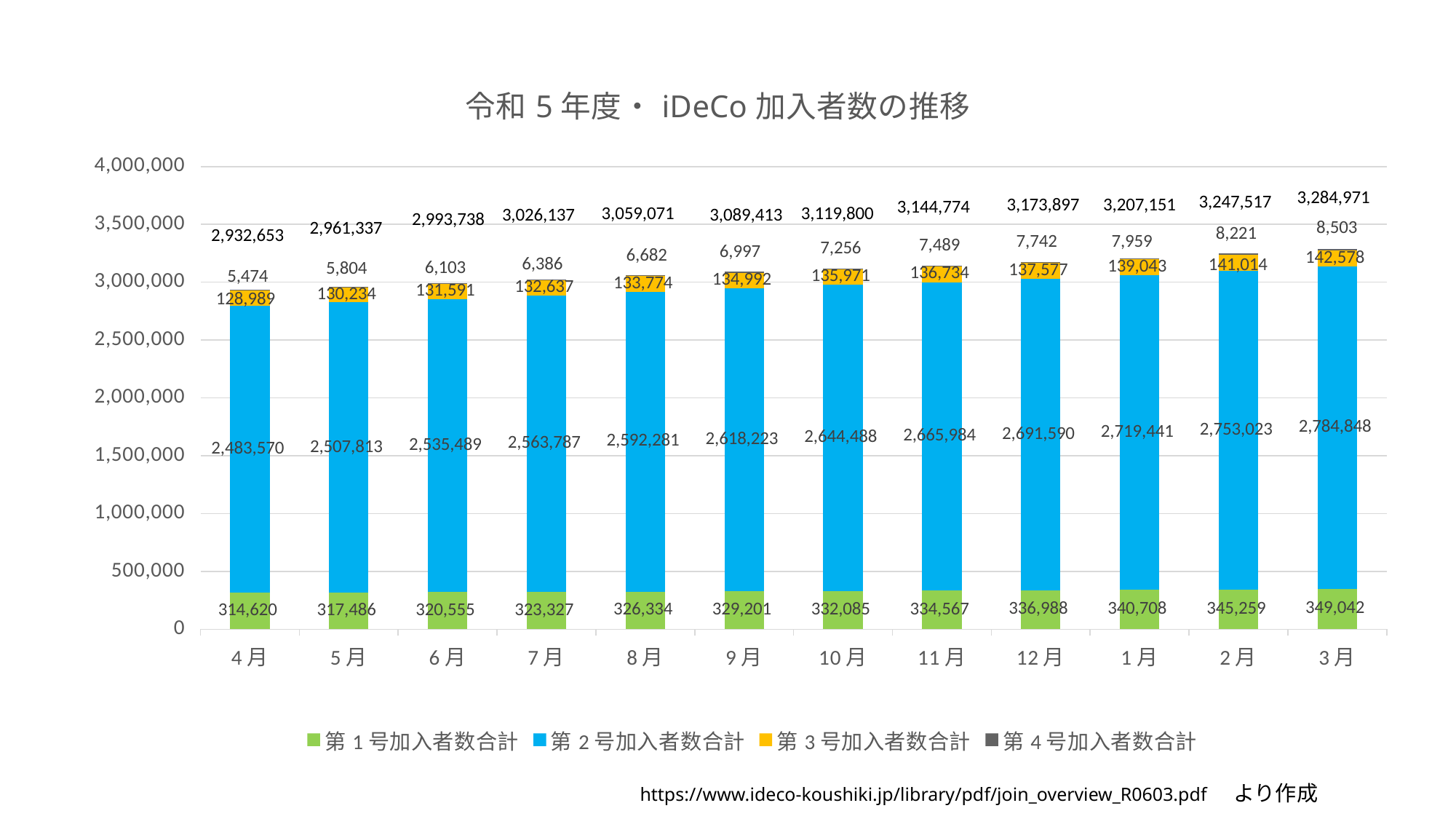
Which month has the highest total number of participants? 3月 What is the value of 第4号加入者数合計 for 8月? 6,682 What is the value of 第2号加入者数合計 for 4月? 2,483,570 What is the difference between the 第2号加入者数合計 values for 3月 and 4月? 301,278 What is the value of 第3号加入者数合計 for 10月? 135,971 How many months are shown on the x axis? 12 What is the total of the stacked bar for 3月? 3,284,971 Which month has the lowest value for 第1号加入者数合計? 4月 What kind of chart is shown on the slide? Stacked bar chart Do the total values rise or fall from 4月 to 3月? Rise How many series does the legend list? 4 What is the value of 第1号加入者数合計 for 3月? 349,042